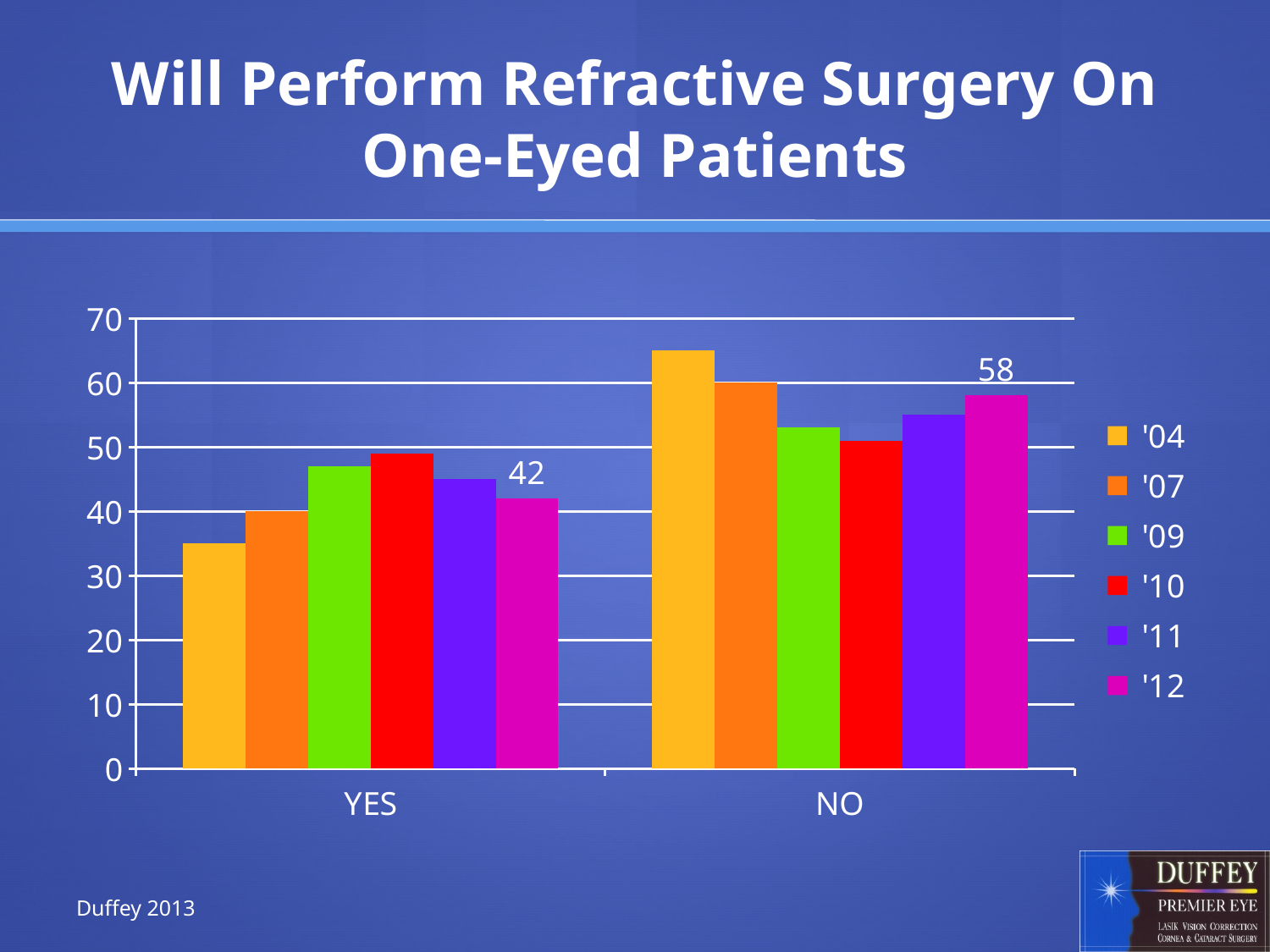
What kind of chart is shown on the slide? bar chart Is the value for '04 in the YES category greater or less than 40? less How many categories are shown on the x axis? 2 What is the title of the chart? Will Perform Refractive Surgery On One-Eyed Patients Within the NO category, which year has the highest bar? '04 Which is larger for '12: the YES value or the NO value? NO How many series does the legend list? 6 Is the value for '04 in the NO category greater or less than 60? greater Within the YES category, which year has the lowest bar? '04 What is the difference between the '12 values for NO and YES? 16 What is the value for '12 in the NO category? 58 What is the value for '12 in the YES category? 42